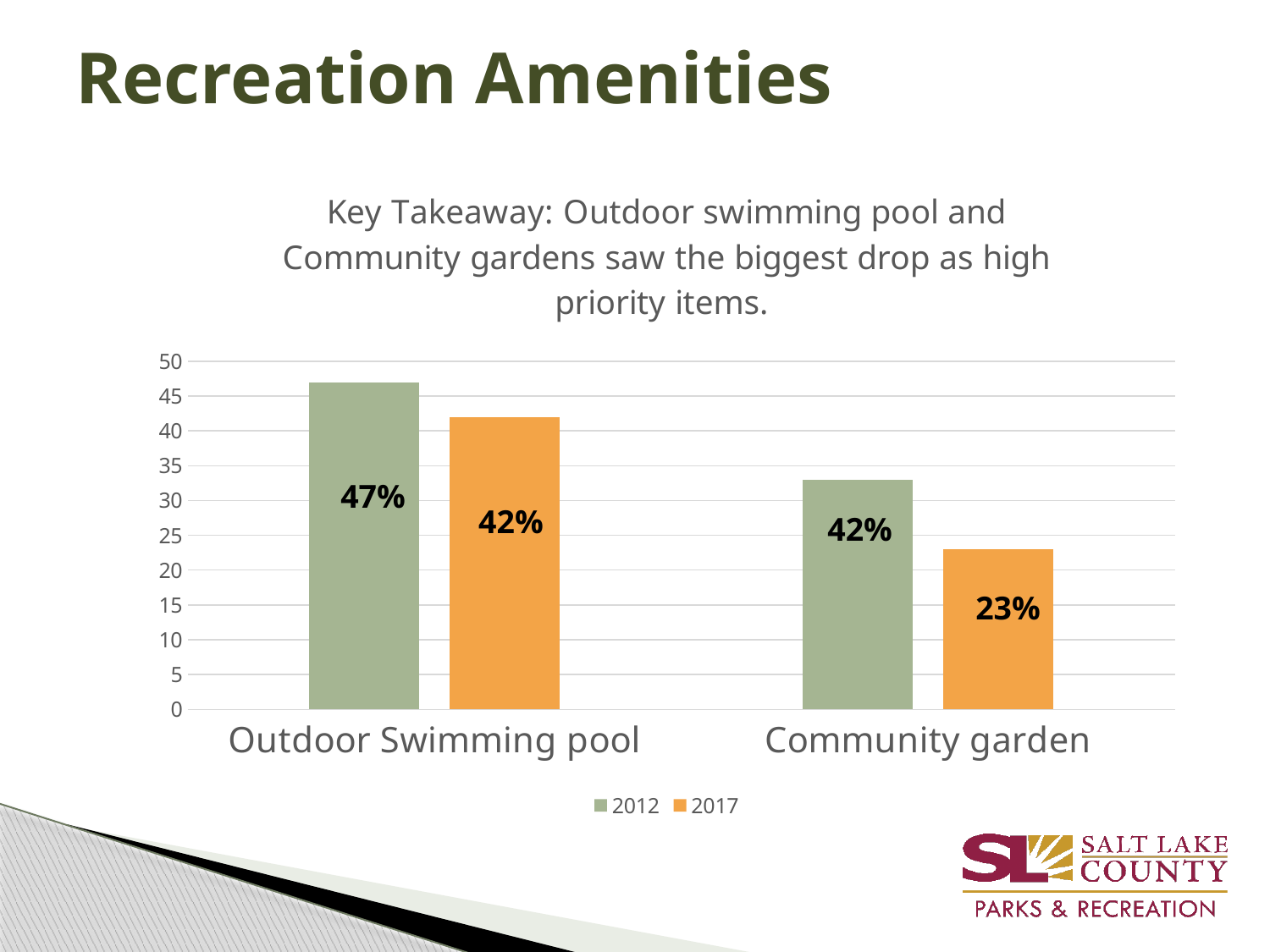
Which category has the highest 2012 value? Outdoor Swimming pool Which is larger: the 2017 value for Outdoor Swimming pool or the 2017 value for Community garden? Outdoor Swimming pool How many categories are shown on the x axis? 2 What is the 2017 value for Community garden? 23% Which category has the lowest 2017 value? Community garden How many series does the legend list? 2 What is the difference between the 2012 and 2017 values for Outdoor Swimming pool? 5% What is the 2017 value for Outdoor Swimming pool? 42% What kind of chart is shown on the slide? Bar chart What is the 2012 value for Community garden? 42% What is the 2012 value for Outdoor Swimming pool? 47% What is the difference between the 2012 and 2017 values for Community garden? 19%